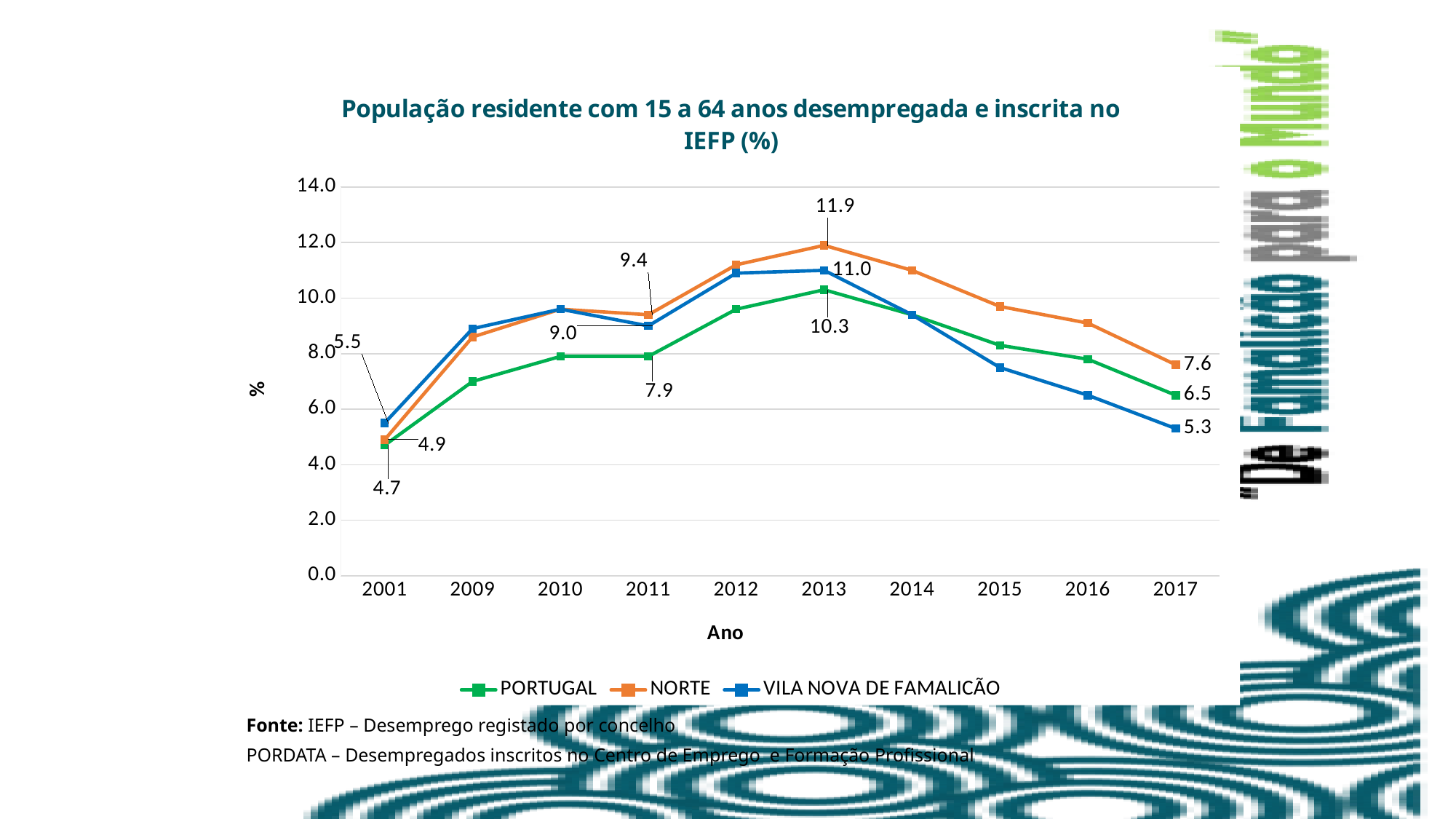
How many series does the legend list? 3 Is the value for VILA NOVA DE FAMALICÃO in 2016 greater or less than 8.0? less In 2017, which is larger: the value for NORTE or the value for VILA NOVA DE FAMALICÃO? NORTE What kind of chart is shown on the slide? Line chart How many years are shown on the x axis? 10 What is the difference between the NORTE and PORTUGAL values in 2013? 1.6 Does the VILA NOVA DE FAMALICÃO series rise or fall from 2013 to 2017? Fall Which series has the lowest value in 2017? VILA NOVA DE FAMALICÃO What is the value for NORTE in 2013? 11.9 What is the value for PORTUGAL in 2001? 4.7 What is the value for VILA NOVA DE FAMALICÃO in 2017? 5.3 In which year does the NORTE series reach its highest value? 2013